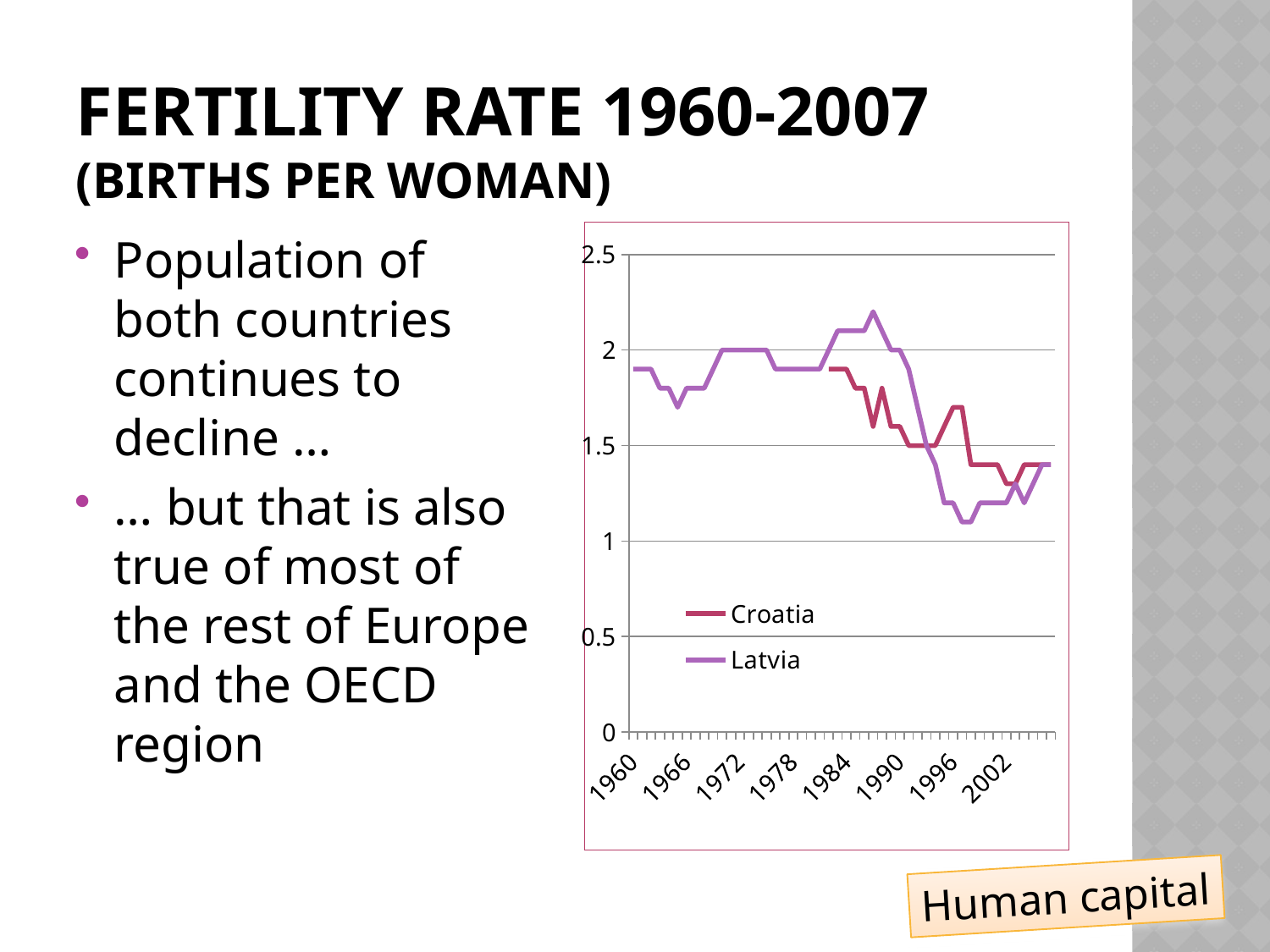
Overall, do the fertility rates for Croatia and Latvia rise or fall from 1960 to 2007? fall What is the highest value shown on the chart's vertical axis? 2.5 Which two countries are shown in the chart's legend? Croatia and Latvia How many year labels are printed along the chart's horizontal axis? 8 Is the value for Latvia in 1996 greater or less than 1.5? less Around 1996, which series has the higher value, Croatia or Latvia? Croatia How many series does the chart's legend list? 2 What kind of chart is shown on the slide? line chart Around 1987, which series has the higher value, Croatia or Latvia? Latvia Is the value for Latvia in 1960 greater or less than 1.5? greater Is the peak value for Latvia in the late 1980s greater or less than 2? greater